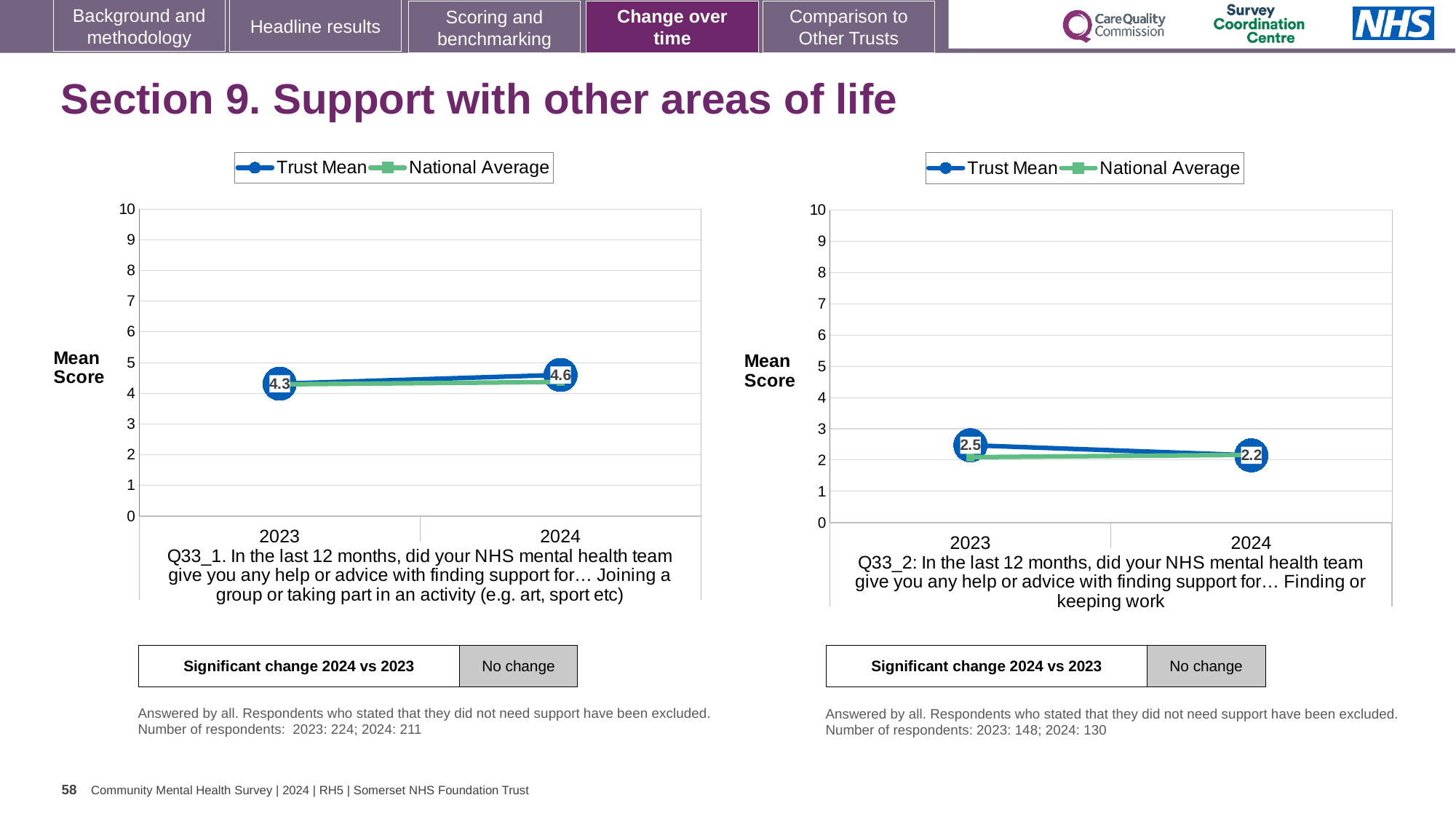
In the left chart (Q33_1), does the Trust Mean rise or fall from 2023 to 2024? rise What kind of chart is the right chart (Q33_2)? line chart In the left chart (Q33_1), by how much did the Trust Mean change from 2023 to 2024? 0.3 In the left chart (Q33_1), what is the Trust Mean for 2023? 4.3 In the right chart (Q33_2), what is the Trust Mean for 2024? 2.2 In the right chart (Q33_2), does the Trust Mean rise or fall from 2023 to 2024? fall In the left chart (Q33_1), is the National Average for 2024 greater or less than 5? less In the right chart (Q33_2), what is the difference between the Trust Mean in 2023 and 2024? 0.3 How many series does the legend of the left chart (Q33_1) list? 2 In the right chart (Q33_2), which year has the higher Trust Mean, 2023 or 2024? 2023 In the right chart (Q33_2), what is the Trust Mean for 2023? 2.5 In the left chart (Q33_1), what is the Trust Mean for 2024? 4.6